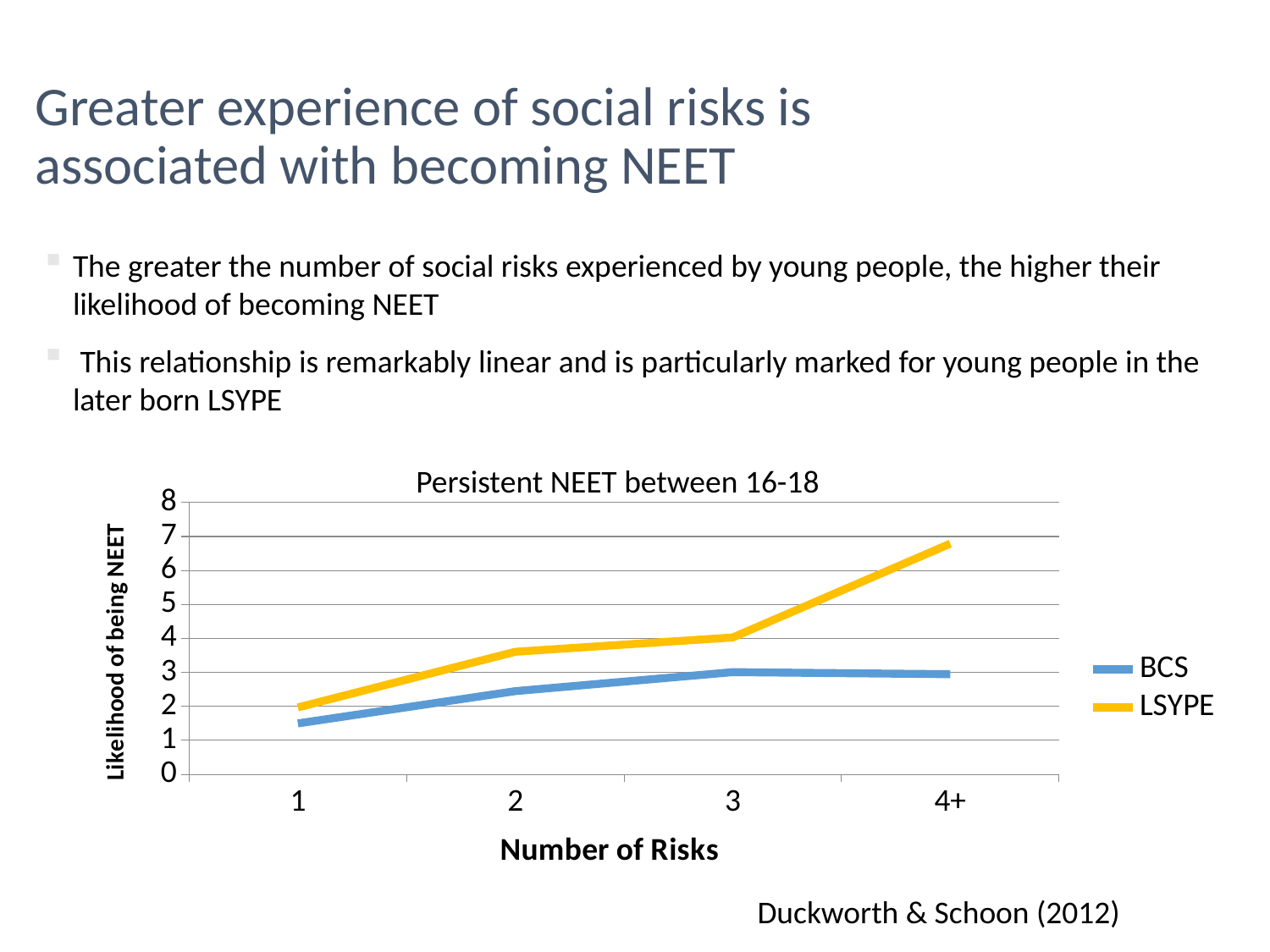
Is the LSYPE value at 4+ risks greater or less than 6? greater At 4+ risks, which series has the higher value, BCS or LSYPE? LSYPE Is the BCS value at 4+ risks greater or less than 4? less What is the label of the x axis of the chart? Number of Risks Is the BCS value at 1 risk greater or less than 2? less At which number of risks is the BCS value lowest? 1 Does the LSYPE line rise or fall as the number of risks increases from 1 to 4+? rise How many series does the chart legend list? 2 What kind of chart is shown on the slide? line chart How many categories are shown on the x axis of the chart? 4 At which number of risks is the LSYPE value highest? 4+ What is the title of the chart? Persistent NEET between 16-18